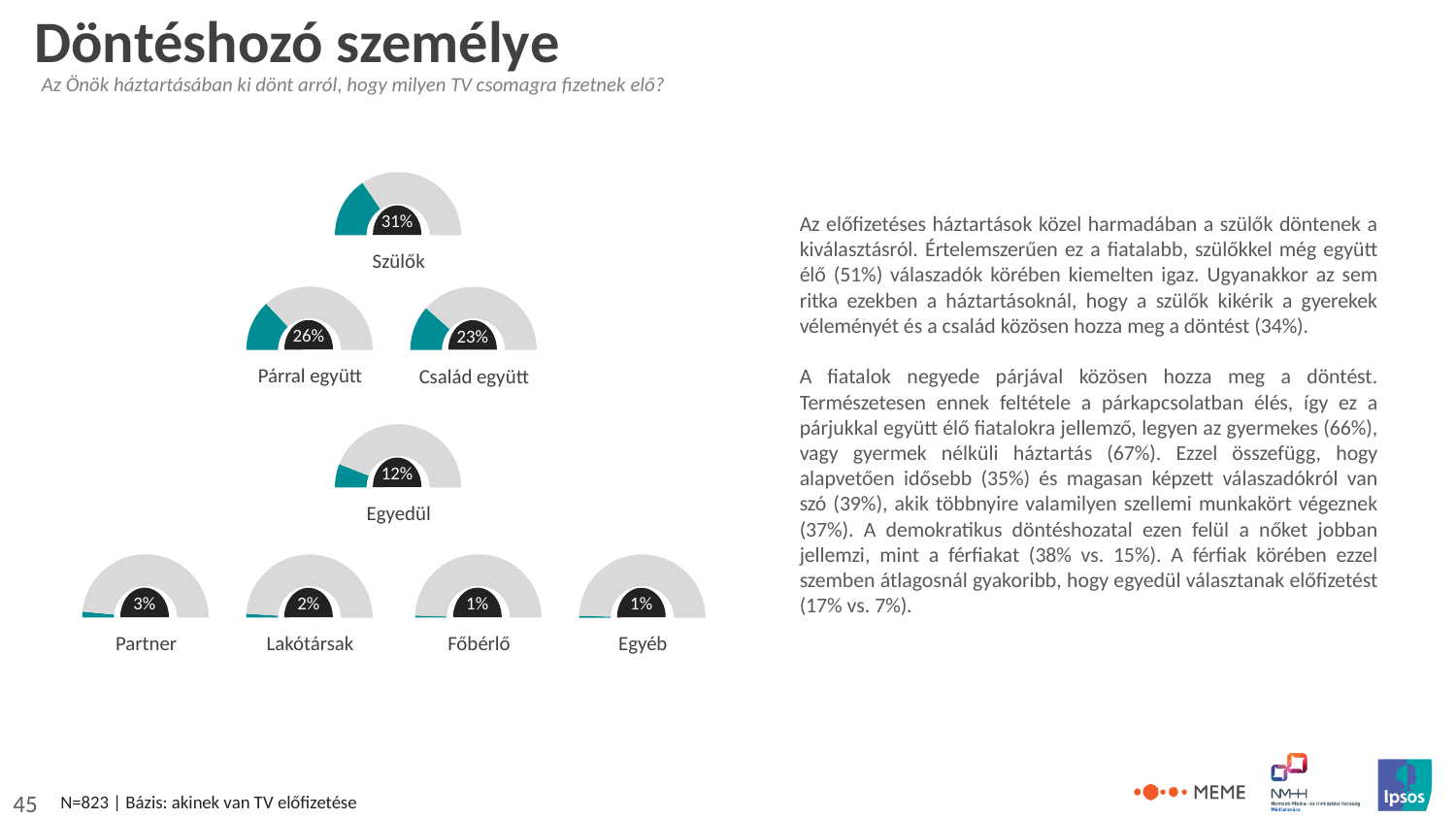
Which is larger, the value for Párral együtt or the value for Család együtt? Párral együtt How many categories are shown in the chart? 8 Which category has the highest percentage? Szülők What is the title of the slide containing the chart? Döntéshozó személye What is the difference in percentage points between Párral együtt and Egyedül? 14 What kind of chart is used to display the values? Gauge (semi-circle donut) charts What percentage is shown for Egyedül? 12% What percentage is shown for Párral együtt? 26% What percentage is shown for Szülők? 31% What percentage is shown for Lakótársak? 2% What is the difference in percentage points between Szülők and Család együtt? 8 Which is larger, the value for Partner or the value for Lakótársak? Partner